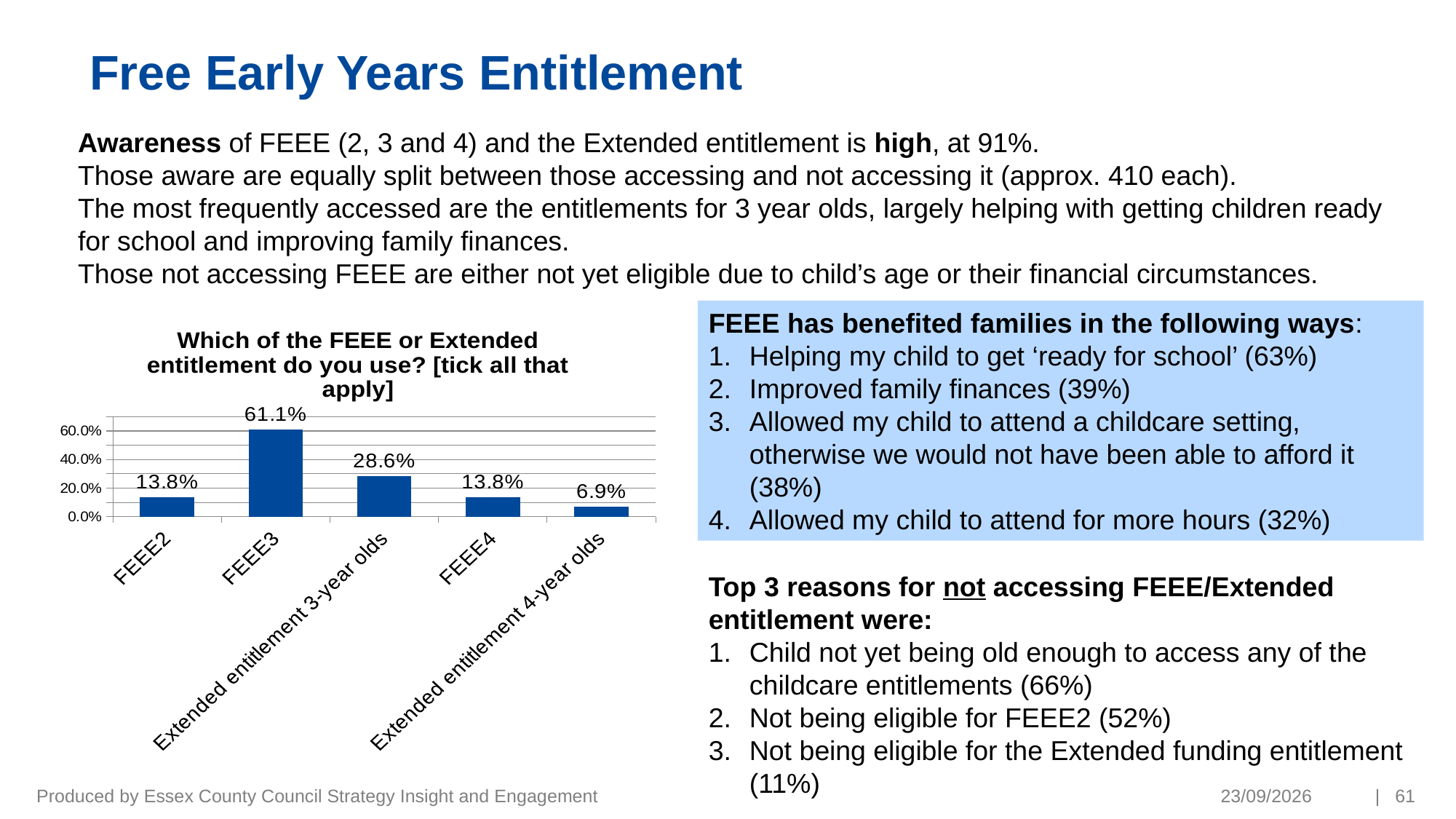
What is the difference between the values for FEEE3 and Extended entitlement 3-year olds? 32.5% Is the value for FEEE3 greater or less than 40.0%? greater What is the title of the chart? Which of the FEEE or Extended entitlement do you use? [tick all that apply] What percentage of respondents use FEEE3? 61.1% Which is larger, the value for FEEE2 or the value for Extended entitlement 3-year olds? Extended entitlement 3-year olds What is the value shown for Extended entitlement 3-year olds? 28.6% Which category has the lowest value in the chart? Extended entitlement 4-year olds What percentage is shown for Extended entitlement 4-year olds? 6.9% What kind of chart is shown on the slide? Bar chart How many categories are shown on the x axis of the chart? 5 Do FEEE2 and FEEE4 have the same value in the chart? Yes, both 13.8% Which entitlement has the highest percentage of use in the chart? FEEE3